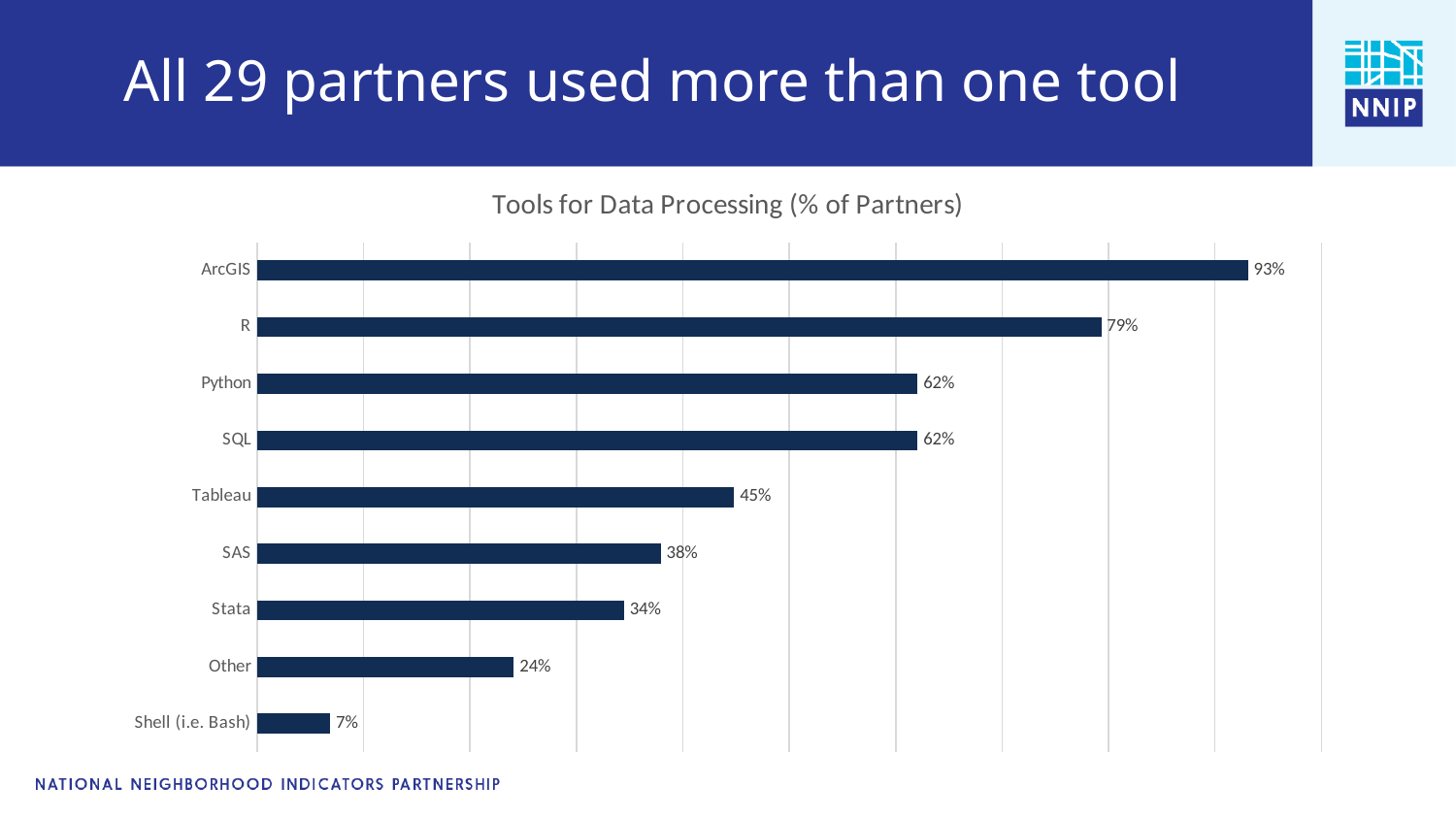
Which has a higher percentage of partners, Stata or Tableau? Tableau What is the difference in percentage points between SAS and Other? 14 What percentage of partners use Stata? 34% Which has a higher percentage of partners, R or Python? R What percentage of partners use ArcGIS for data processing? 93% What is the title of the chart? Tools for Data Processing (% of Partners) Which tool has the lowest percentage of partners? Shell (i.e. Bash) How many tools are listed in the chart? 9 What is the value shown for Tableau? 45% Which tool has the highest percentage of partners? ArcGIS What is the difference in percentage points between ArcGIS and R? 14 What kind of chart is shown on the slide? Bar chart